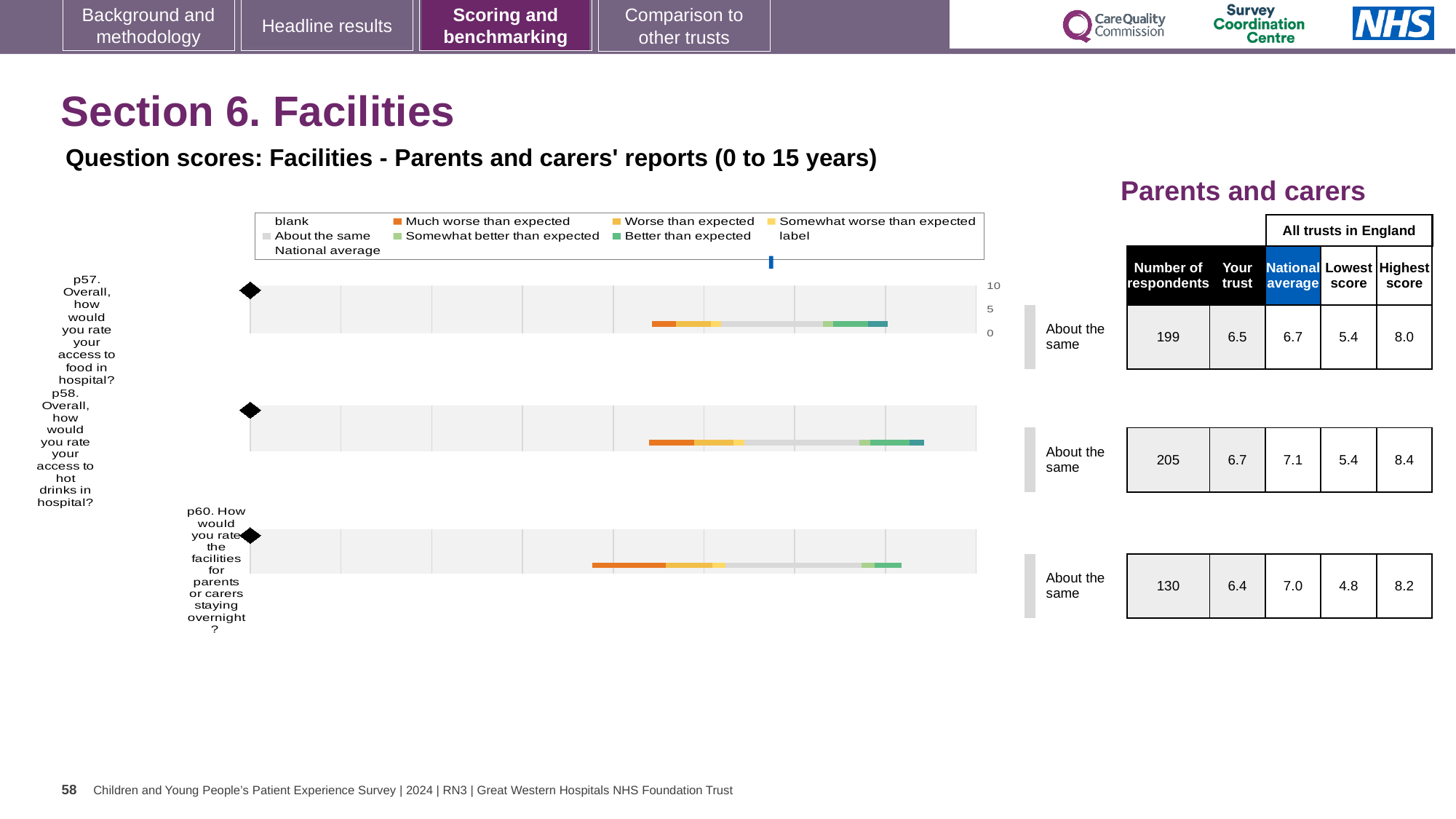
How many questions (bars) are plotted in the Facilities charts on this slide? 3 What kind of chart is used to show the question scores for p57, p58 and p60? bar chart In the table beside the charts, which question has the highest 'Highest score' across all trusts in England? p58 In the table beside the charts, what is the difference between the national average and the 'Your trust' score for p60? 0.6 What is the subtitle above the charts describing the question scores? Question scores: Facilities - Parents and carers' reports (0 to 15 years) In the table beside the charts, what is the national average for p58 (access to hot drinks in hospital)? 7.1 What benchmark category is shown for all three questions (p57, p58, p60)? About the same In the table beside the charts, which question has the lowest 'Lowest score' across all trusts in England? p60 In the legend, what colour represents 'Much worse than expected'? orange In the table beside the charts, how many respondents answered p60 (facilities for parents or carers staying overnight)? 130 In the table beside the charts, what is the 'Your trust' score for p57 (access to food in hospital)? 6.5 How many entries does the legend above the charts list? 9